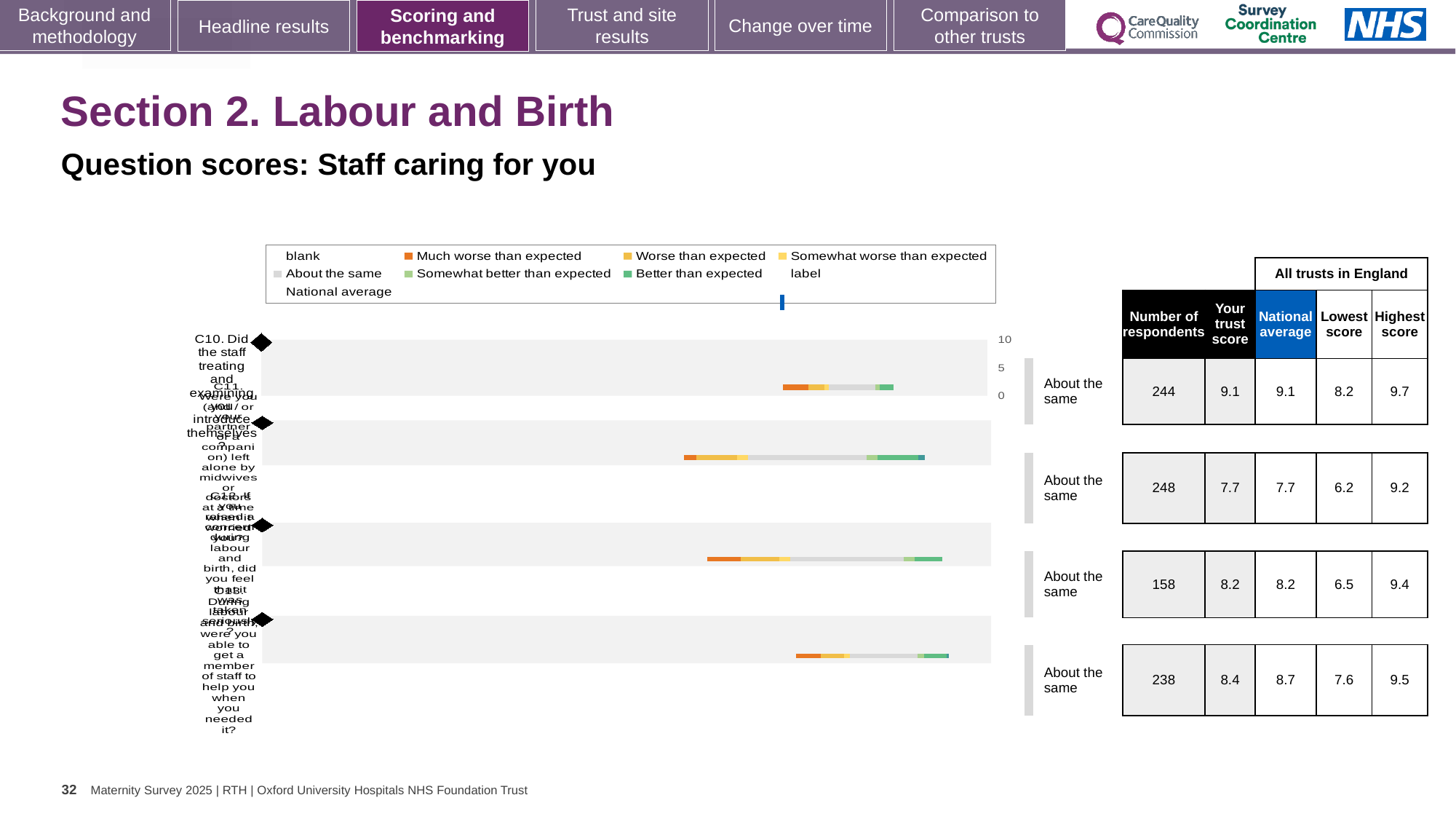
In the table beside the chart, which row has the highest 'Your trust score'? the first row (9.1) What benchmark label is shown next to each bar in the chart? About the same How many horizontal bars are plotted in the chart? 4 In the table beside the chart, which row has the lowest number of respondents? the third row (158) In the table beside the chart, what is the difference between the highest score and the lowest score in the second row? 3.0 In the table beside the chart, what is 'Your trust score' for the fourth row? 8.4 In the table beside the chart, what is the number of respondents for the first row? 244 What kind of chart is shown on the slide? bar chart In the table beside the chart, what is the national average for the third row? 8.2 In the table beside the chart, for the fourth row, which is larger: 'Your trust score' or the 'National average'? National average In the chart legend, what colour represents 'Better than expected'? green In the chart legend, what colour represents 'Much worse than expected'? orange